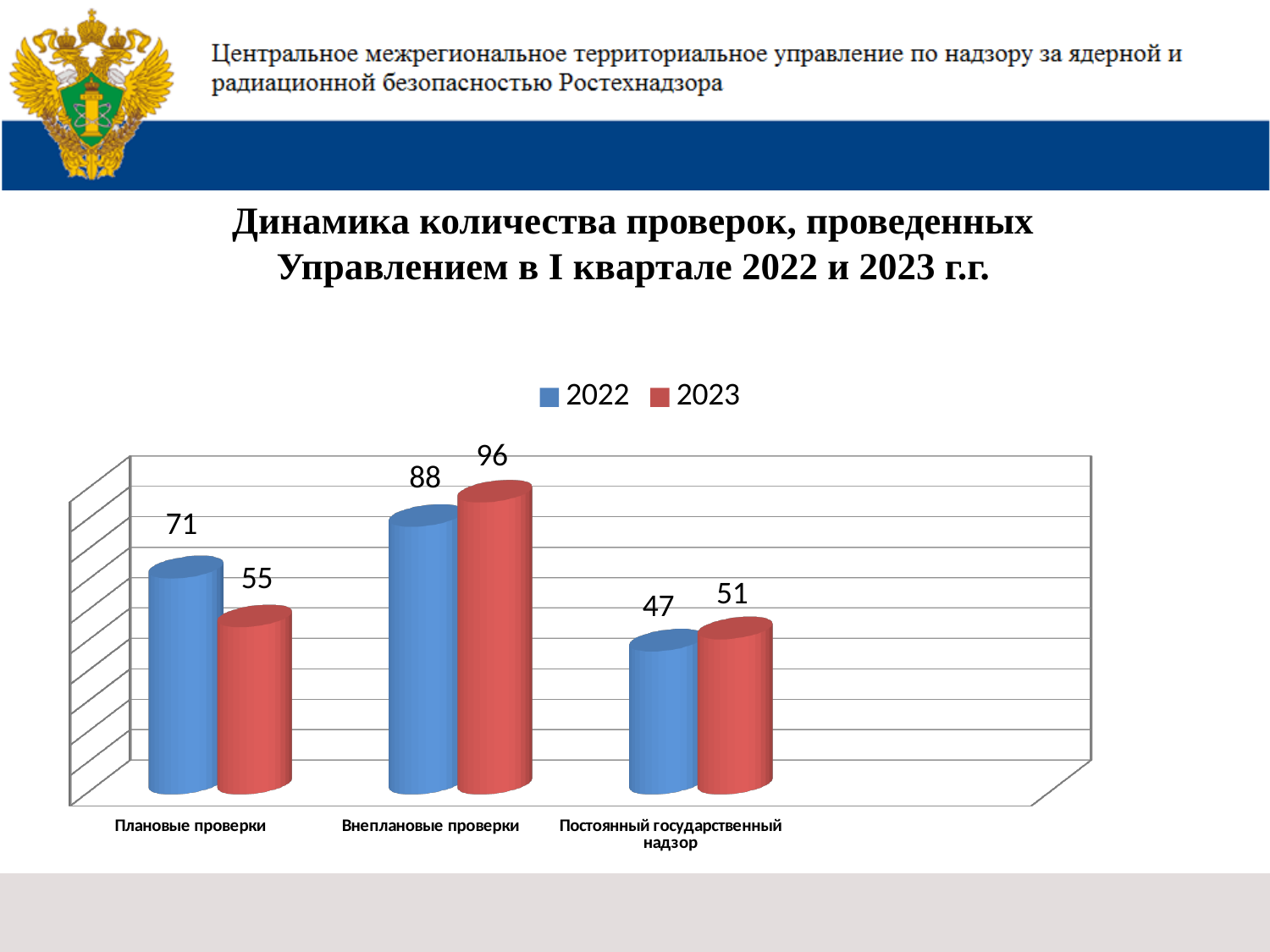
Which colour represents the 2023 series? Red What kind of chart is shown on the slide? Bar chart What is the difference between the 2023 and 2022 values for Внеплановые проверки? 8 How many categories are shown on the x axis? 3 What is the value for Плановые проверки in 2022? 71 Which category has the highest value for 2023? Внеплановые проверки What is the value for Внеплановые проверки in 2023? 96 How many series does the legend list? 2 Which category has the lowest value for 2022? Постоянный государственный надзор What is the value for Постоянный государственный надзор in 2022? 47 Which is larger for Постоянный государственный надзор: the 2022 value or the 2023 value? 2023 What is the difference between the 2022 and 2023 values for Плановые проверки? 16